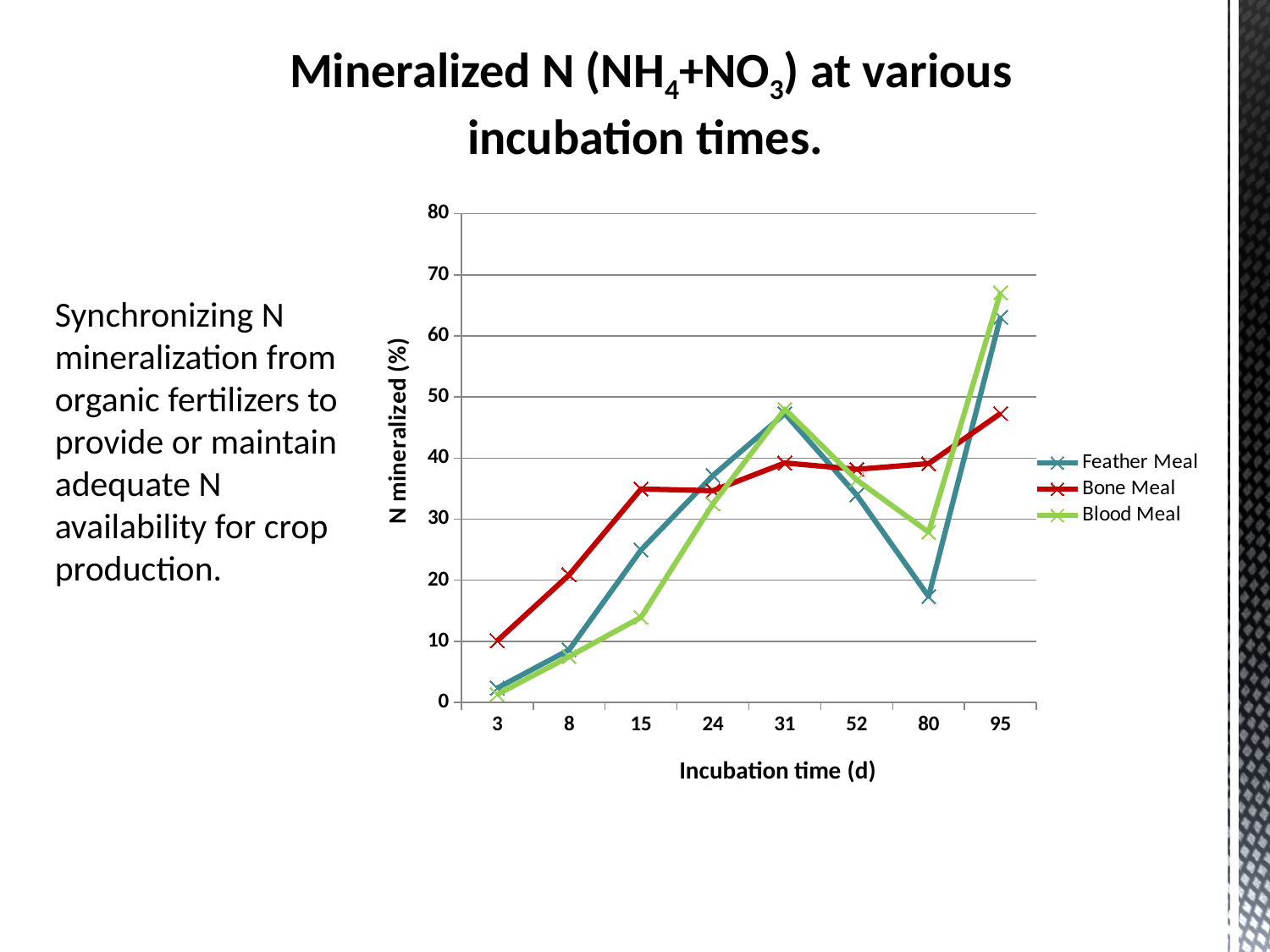
At 80 days, which is larger: Bone Meal or Feather Meal? Bone Meal Is the value for Bone Meal at 15 days greater or less than 30? greater Is the value for Feather Meal at 80 days greater or less than 20? less What kind of chart is shown on the slide? line chart How many series does the legend list? 3 How many incubation times are plotted along the x axis? 8 What is the title of the y axis? N mineralized (%) Which series has the lowest value at 80 days? Feather Meal At 95 days, which is larger: Blood Meal or Bone Meal? Blood Meal Is the value for Blood Meal at 95 days greater or less than 60? greater Which series has the highest value at 95 days? Blood Meal Does the Bone Meal series rise or fall from 3 days to 15 days? rise